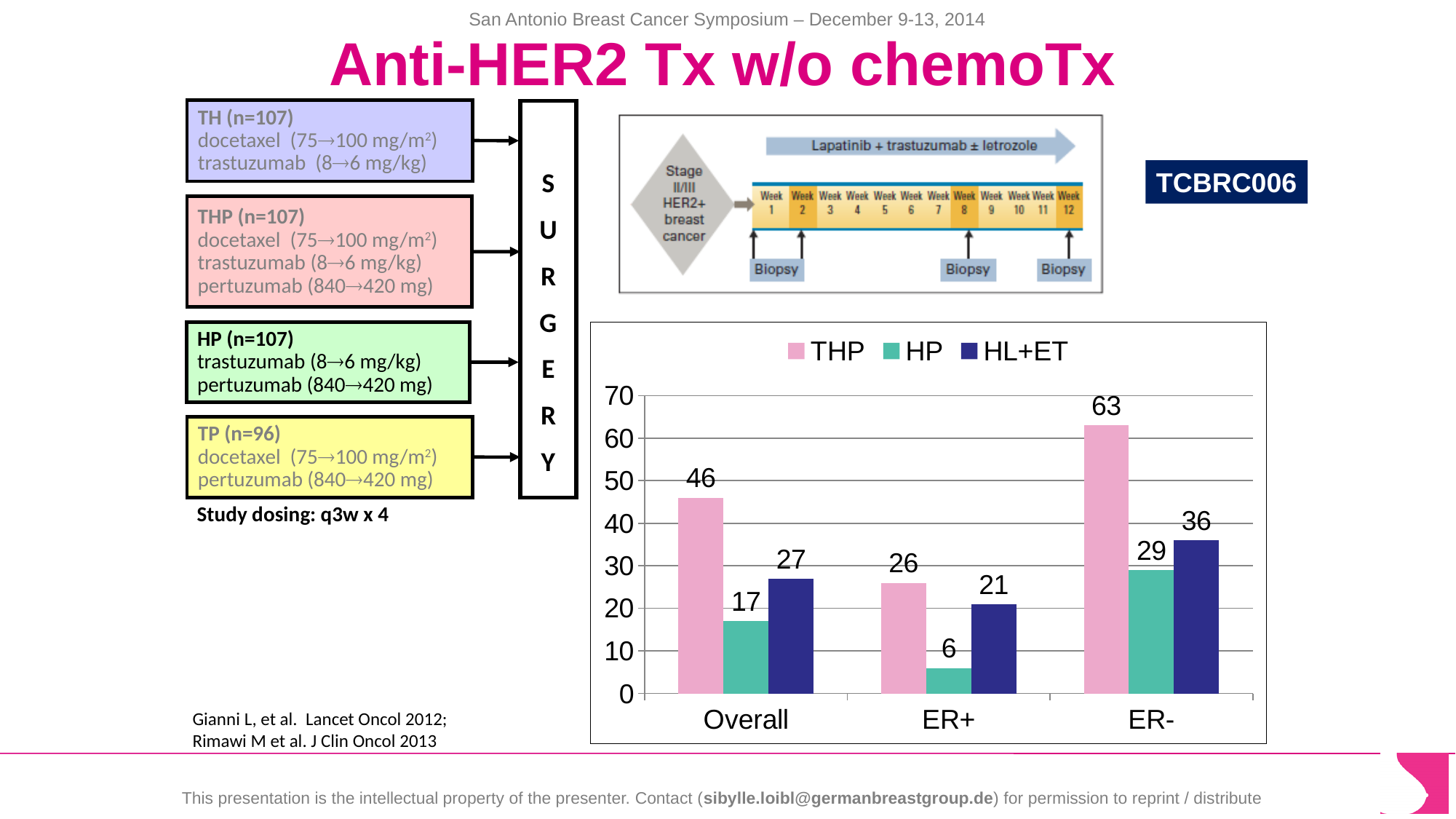
Which category has the lowest HP value? ER+ How many categories are shown on the x axis of the bar chart? 3 Which category has the highest THP value? ER- What is the value for HP in the ER+ category? 6 Is the THP value for ER- greater or less than 60? greater Which is larger in the Overall category, the HP value or the HL+ET value? HL+ET How many series does the legend of the bar chart list? 3 What is the value for HL+ET in the ER- category? 36 What colour are the THP bars in the chart? pink What is the value for THP in the Overall category? 46 What kind of chart is shown at the bottom right of the slide? bar chart What is the difference between the THP and HP values in the ER- category? 34